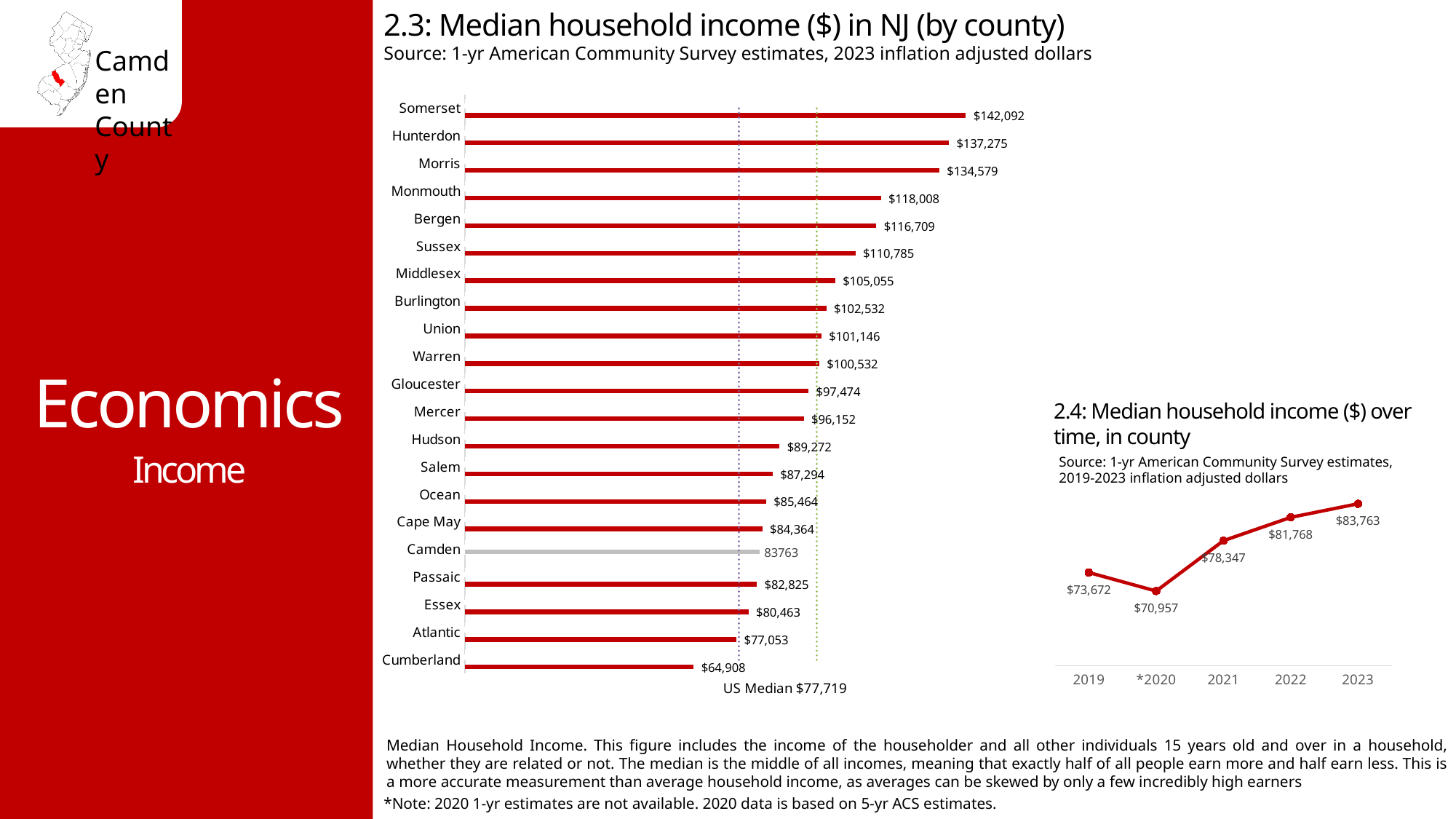
In chart 2.3 (Median household income in NJ by county), what is the difference between Somerset's and Hunterdon's median household income? $4,817 In chart 2.4 (Median household income over time, in county), which year had the lowest median household income? *2020 In chart 2.3 (Median household income in NJ by county), what is the median household income for Morris? $134,579 In chart 2.3 (Median household income in NJ by county), how many counties are shown? 21 In chart 2.4 (Median household income over time, in county), what is the difference between the 2023 and 2019 values? $10,091 In chart 2.3 (Median household income in NJ by county), which has a higher median household income, Monmouth or Bergen? Monmouth In chart 2.4 (Median household income over time, in county), what was the median household income in 2021? $78,347 In chart 2.3 (Median household income in NJ by county), what US median value is noted below the chart? $77,719 In chart 2.3 (Median household income in NJ by county), which county has the highest median household income? Somerset In chart 2.3 (Median household income in NJ by county), what value is labeled for Camden? 83763 In chart 2.3 (Median household income in NJ by county), which county has the lowest median household income? Cumberland What kind of chart is chart 2.4 (Median household income over time, in county)? Line chart